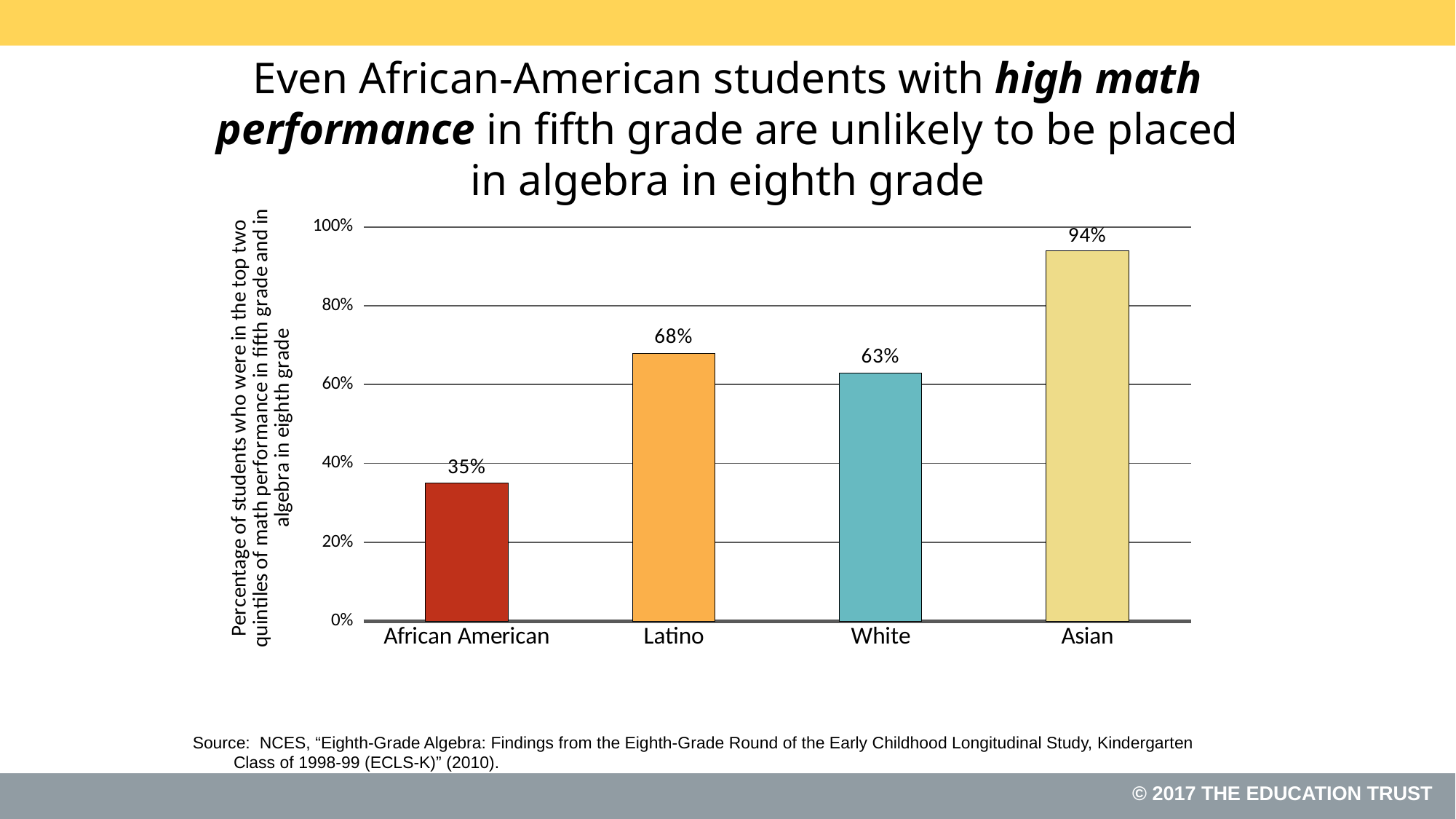
What kind of chart is shown on the slide? bar chart Which group has the lowest value? African American Is the value for African American students greater or less than 40%? less What is the value for Latino students? 68% Which group has the highest value? Asian Which is larger, the value for Latino or for White students? Latino How many groups are shown on the x axis? 4 What is the value for African American students? 35% What is the difference between the values for Latino and White students? 5% What is the value for White students? 63% What is the value for Asian students? 94% What is the difference between the values for Asian and African American students? 59%